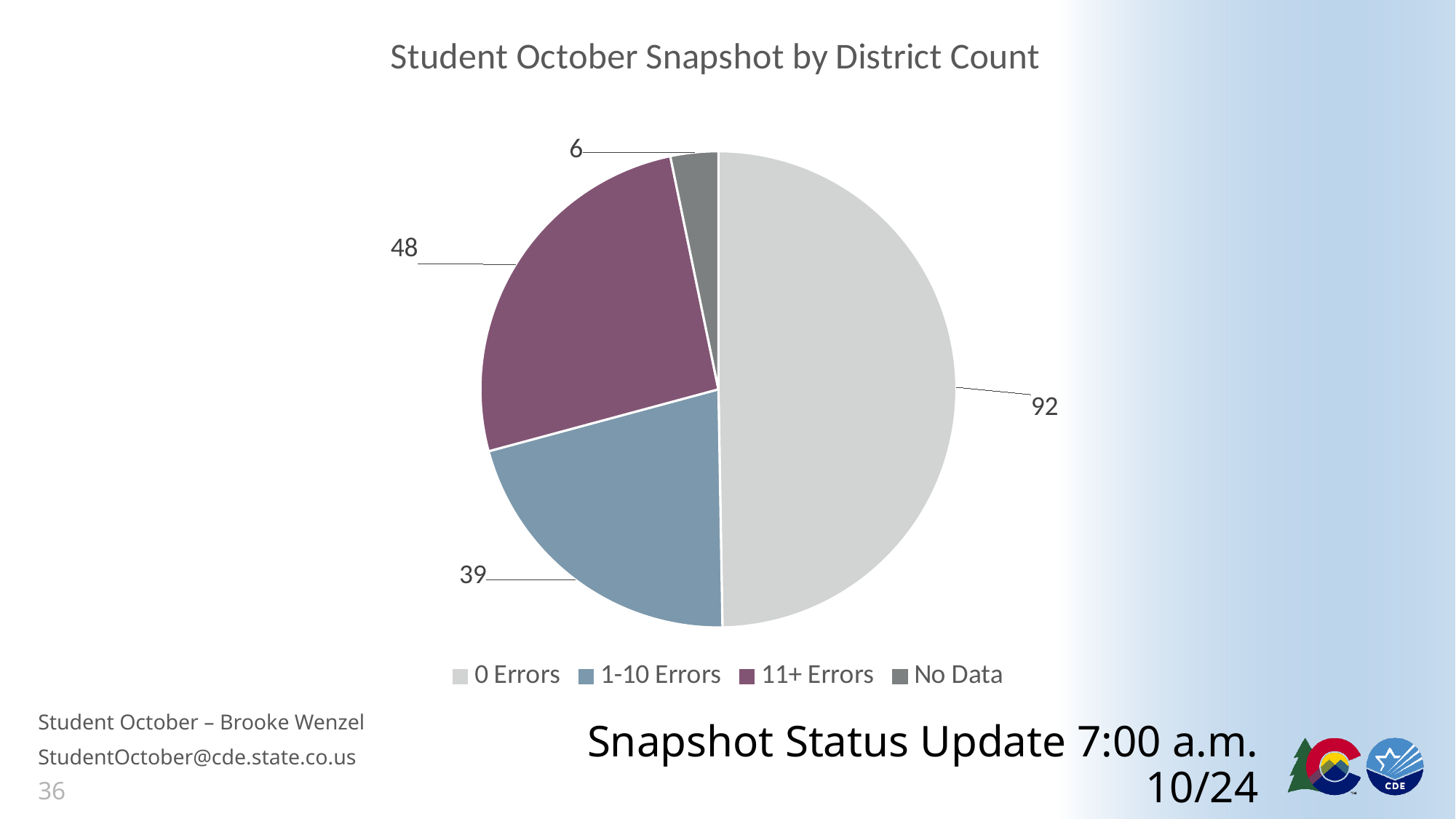
What is the difference between the 0 Errors count and the 11+ Errors count? 44 What type of chart is shown on the slide? Pie chart How many districts are in the 11+ Errors category? 48 How many districts are in the 0 Errors category? 92 Which category has the largest slice of the pie? 0 Errors Which is larger, the 1-10 Errors count or the 11+ Errors count? 11+ Errors Which category has the smallest slice of the pie? No Data How many districts are in the 1-10 Errors category? 39 How many districts are in the No Data category? 6 What is the title of the chart? Student October Snapshot by District Count How many categories does the pie chart have? 4 What is the total number of districts across all slices of the pie? 185